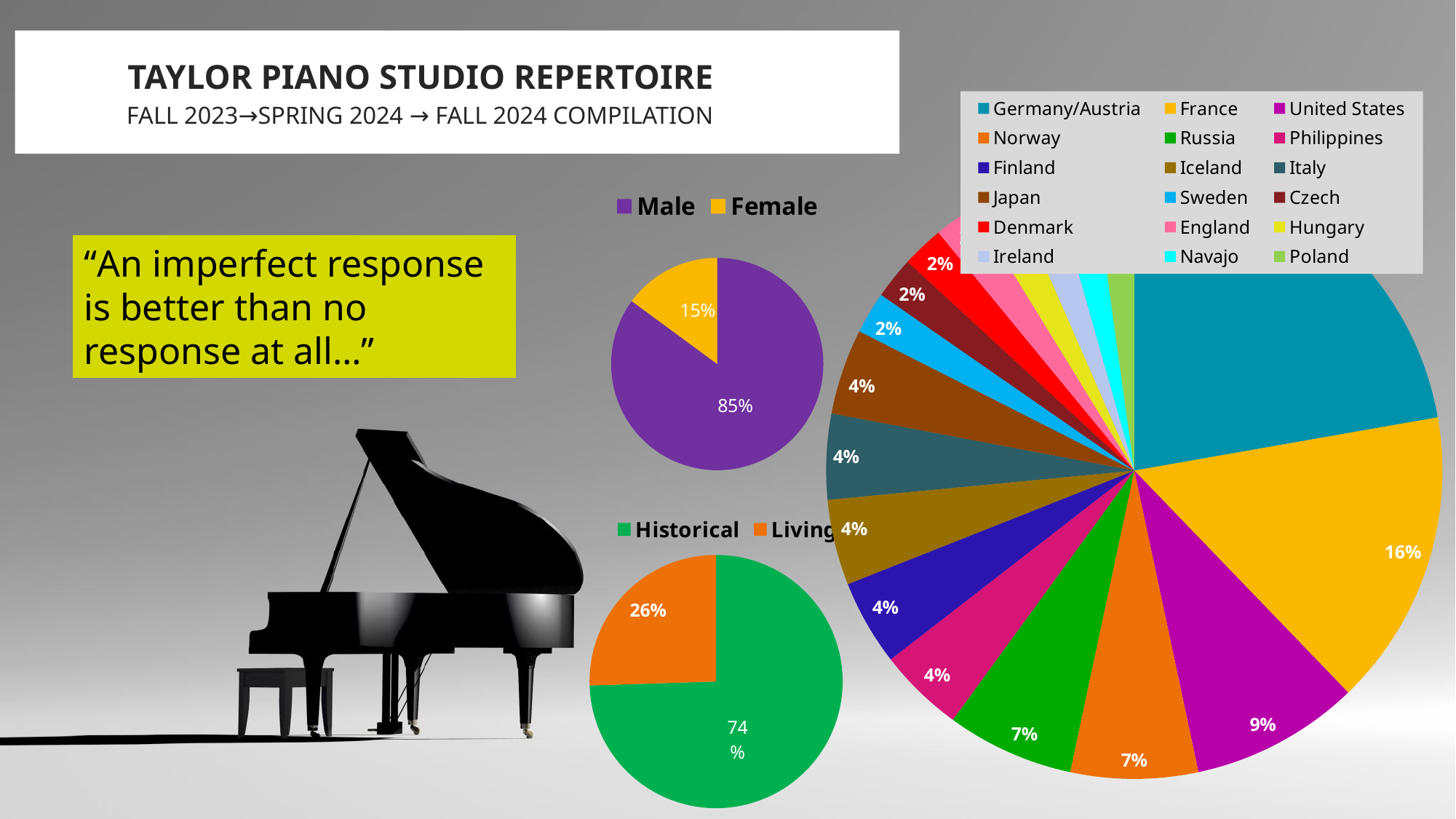
In the large country pie chart, what percentage is France? 16% In the large country pie chart, how many percentage points larger is France than United States? 7 In the Historical/Living pie chart, what share is Living? 26% In the Historical/Living pie chart, what share is Historical? 74% In the Male/Female pie chart, what percentage is Female? 15% What type of chart is the Historical/Living chart? Pie chart In the large country pie chart, what percentage is United States? 9% In the large country pie chart, which country has the largest slice? Germany/Austria In the Male/Female pie chart, what percentage is Male? 85% In the large country pie chart, which slice is larger, Russia or Philippines? Russia How many entries does the legend of the large country pie chart list? 18 In the large country pie chart, what percentage is Norway? 7%